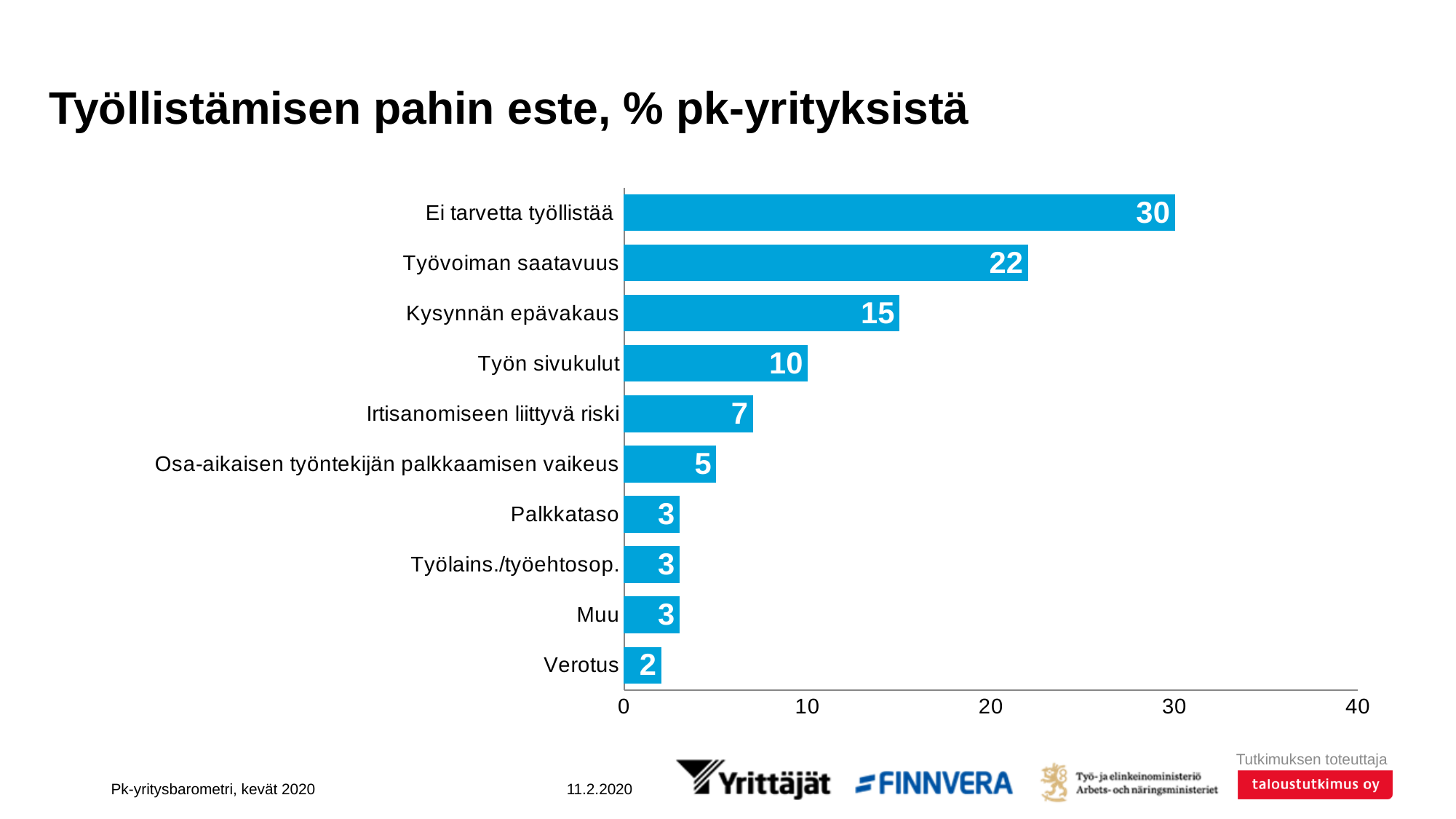
How many categories are shown in the chart? 10 What is the value for Osa-aikaisen työntekijän palkkaamisen vaikeus? 5 What is the value for Kysynnän epävakaus? 15 What is the difference between the values for Työvoiman saatavuus and Työn sivukulut? 12 What kind of chart is shown on the slide? bar chart Which category has the highest value? Ei tarvetta työllistää What is the value for Ei tarvetta työllistää? 30 Which category has the lowest value? Verotus What is the title of the chart? Työllistämisen pahin este, % pk-yrityksistä Is the value for Työvoiman saatavuus greater or less than 20? greater Which is larger, the value for Irtisanomiseen liittyvä riski or the value for Palkkataso? Irtisanomiseen liittyvä riski What is the maximum value shown on the horizontal axis? 40